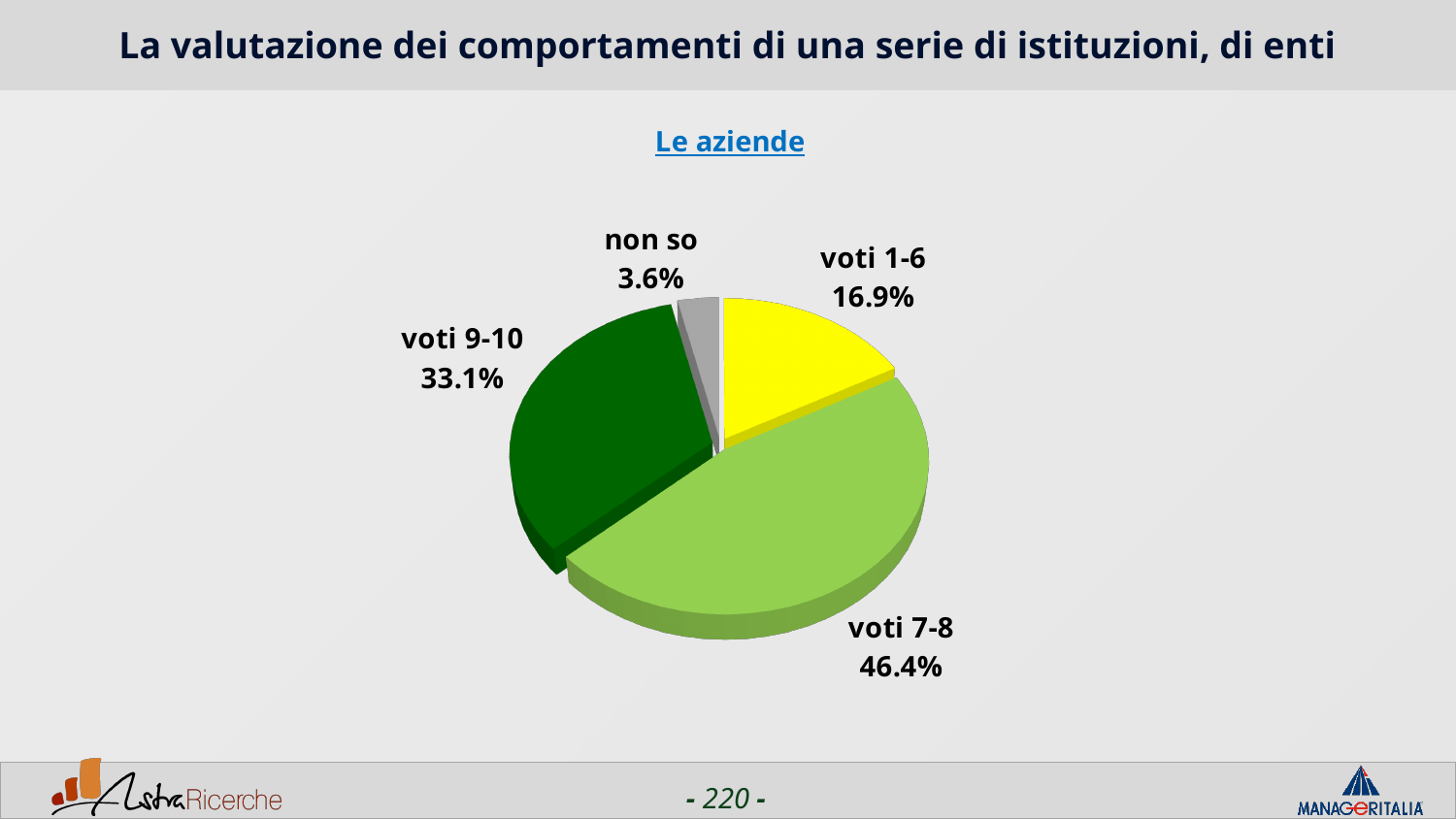
What is the value for 'non so'? 3.6% Which category has the largest share of the pie? voti 7-8 What is the value for 'voti 1-6'? 16.9% What is the subtitle shown above the pie chart? Le aziende Which category has the smallest share of the pie? non so What is the value for 'voti 7-8'? 46.4% What is the difference between the values for 'voti 7-8' and 'voti 9-10'? 13.3% How many slices does the pie chart have? 4 What colour is the 'voti 1-6' slice? yellow Which is larger, the value for 'voti 9-10' or the value for 'voti 1-6'? voti 9-10 What kind of chart is shown on the slide? pie chart What is the value for 'voti 9-10'? 33.1%